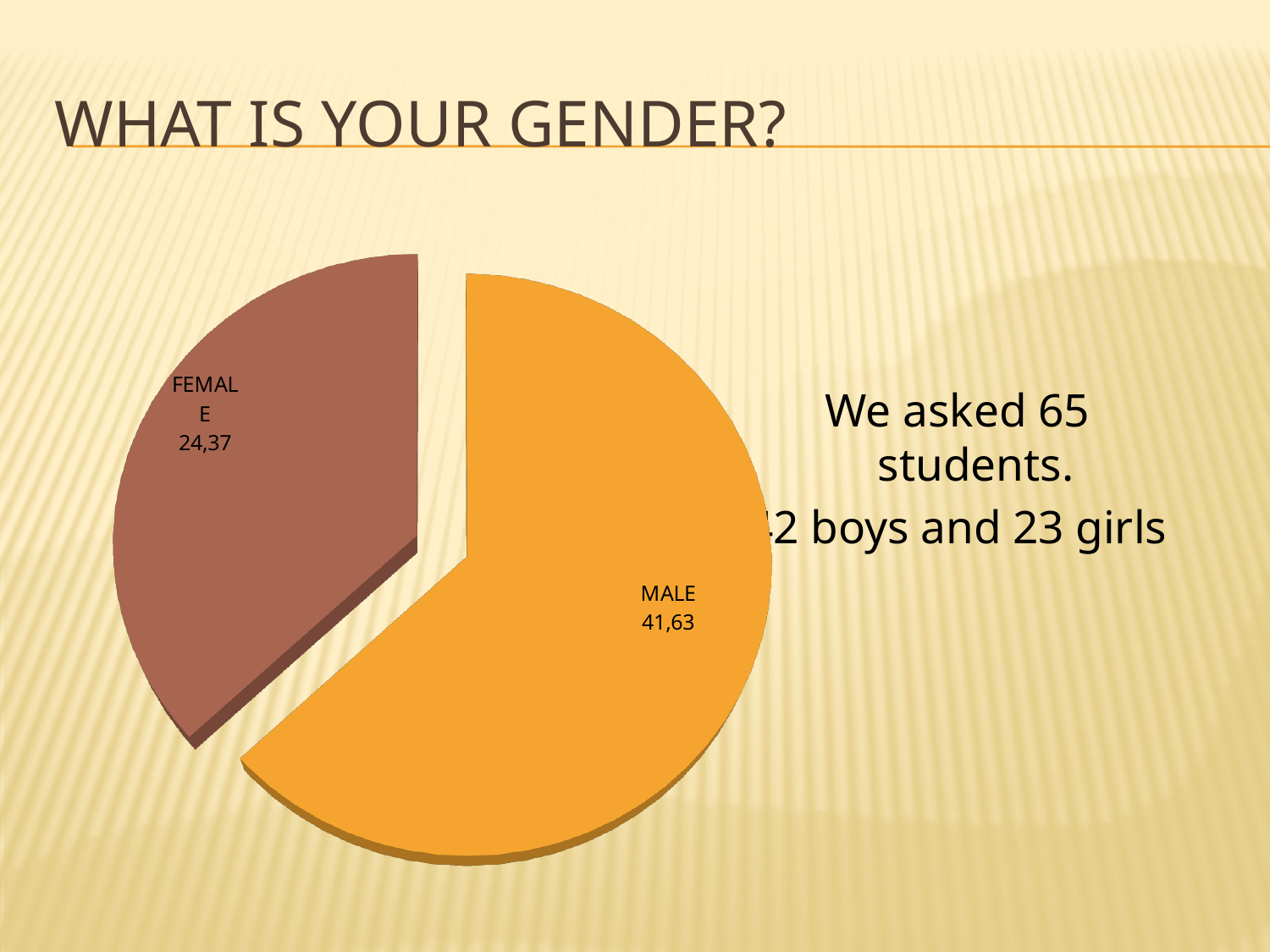
According to the text on the slide, how many students were asked? 65 How many slices does the pie chart have? 2 Which slice of the pie chart is the largest? MALE Which slice of the pie chart is the smallest? FEMALE What is the value shown for the MALE slice? 41,63 What type of chart is shown on the slide? Pie chart What is the title of the slide containing the pie chart? WHAT IS YOUR GENDER? What colour is the MALE slice of the pie chart? Orange Which is larger, the MALE slice or the FEMALE slice? MALE What is the difference between the MALE value and the FEMALE value? 17 What is the value shown for the FEMALE slice? 24,37